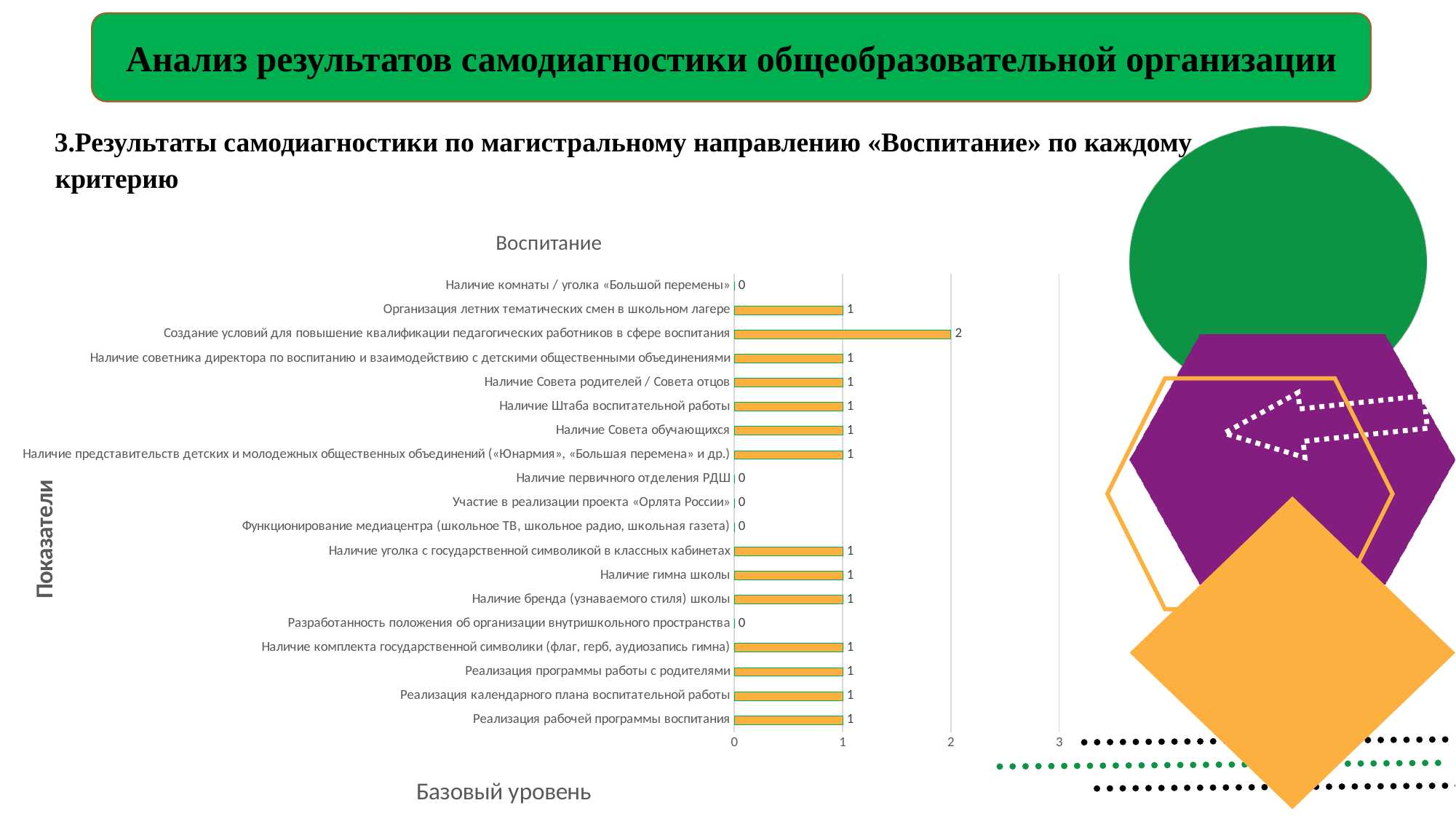
What is the value for «Создание условий для повышение квалификации педагогических работников в сфере воспитания»? 2 What is the label on the vertical axis of the chart? Показатели What is the value for «Участие в реализации проекта «Орлята России»»? 0 What type of chart is shown on the slide? bar chart What is the title of the chart? Воспитание Which category has the highest value? Создание условий для повышение квалификации педагогических работников в сфере воспитания How many categories have a value of 0? 5 What is the difference between the value for «Создание условий для повышение квалификации педагогических работников в сфере воспитания» and the value for «Наличие Совета обучающихся»? 1 What is the value for «Наличие комнаты / уголка «Большой перемены»»? 0 Which is larger: the value for «Наличие бренда (узнаваемого стиля) школы» or the value for «Наличие первичного отделения РДШ»? Наличие бренда (узнаваемого стиля) школы How many categories are shown in the chart? 19 What is the value for «Наличие гимна школы»? 1